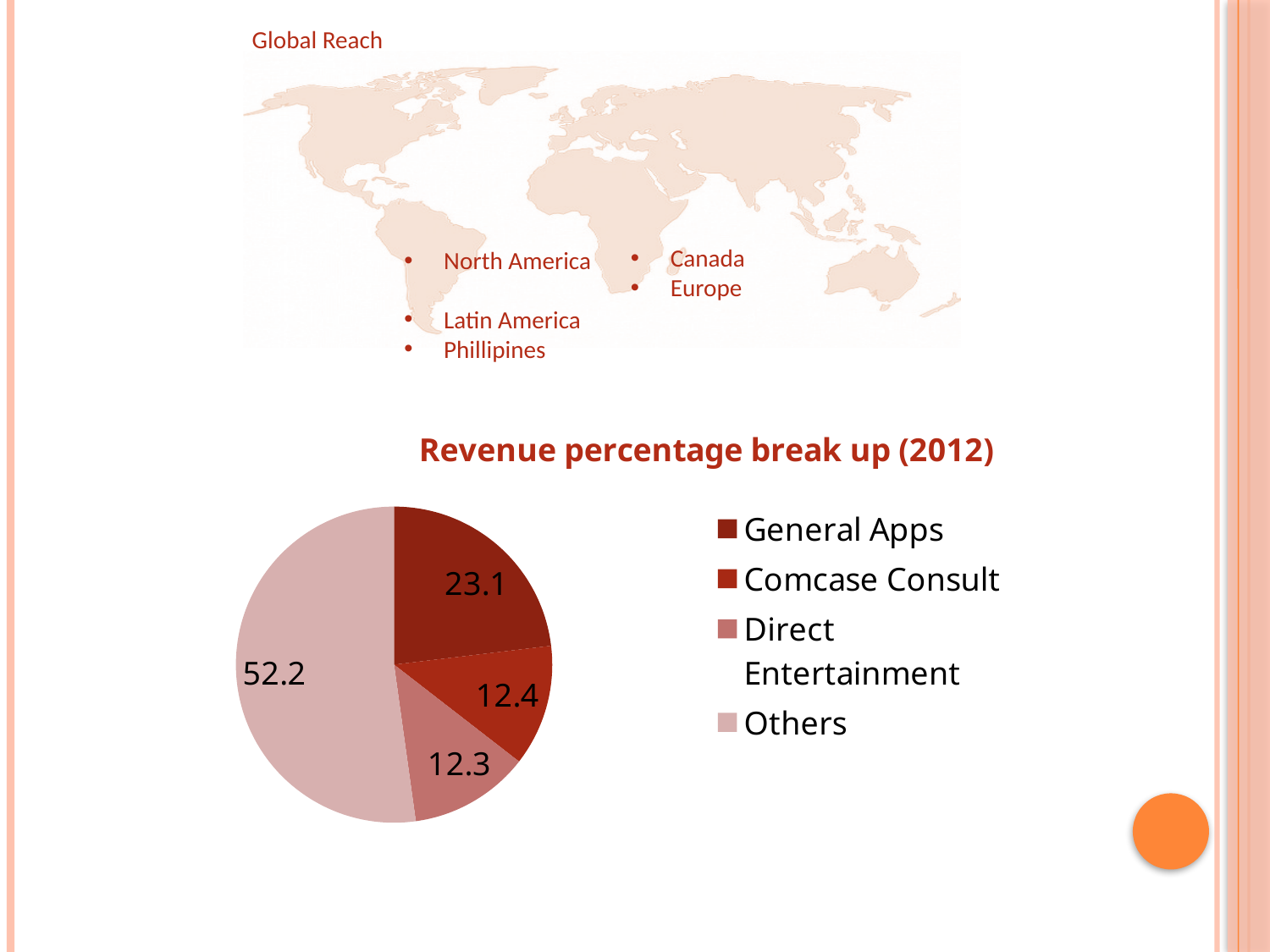
What is the value for Direct Entertainment in the revenue percentage break up pie chart? 12.3 What is the value for Others in the revenue percentage break up pie chart? 52.2 What is the value for Comcase Consult in the revenue percentage break up pie chart? 12.4 What is the difference between the values for Others and General Apps in the pie chart? 29.1 What is the value for General Apps in the revenue percentage break up pie chart? 23.1 How many entries does the legend of the pie chart list? 4 What is the title of the pie chart on the slide? Revenue percentage break up (2012) How many slices does the revenue percentage break up pie chart have? 4 Which category has the larger value in the pie chart, General Apps or Comcase Consult? General Apps What is the difference between the values for General Apps and Comcase Consult in the pie chart? 10.7 What type of chart is shown under the title "Revenue percentage break up (2012)"? Pie chart Which category has the largest slice in the revenue percentage break up pie chart? Others